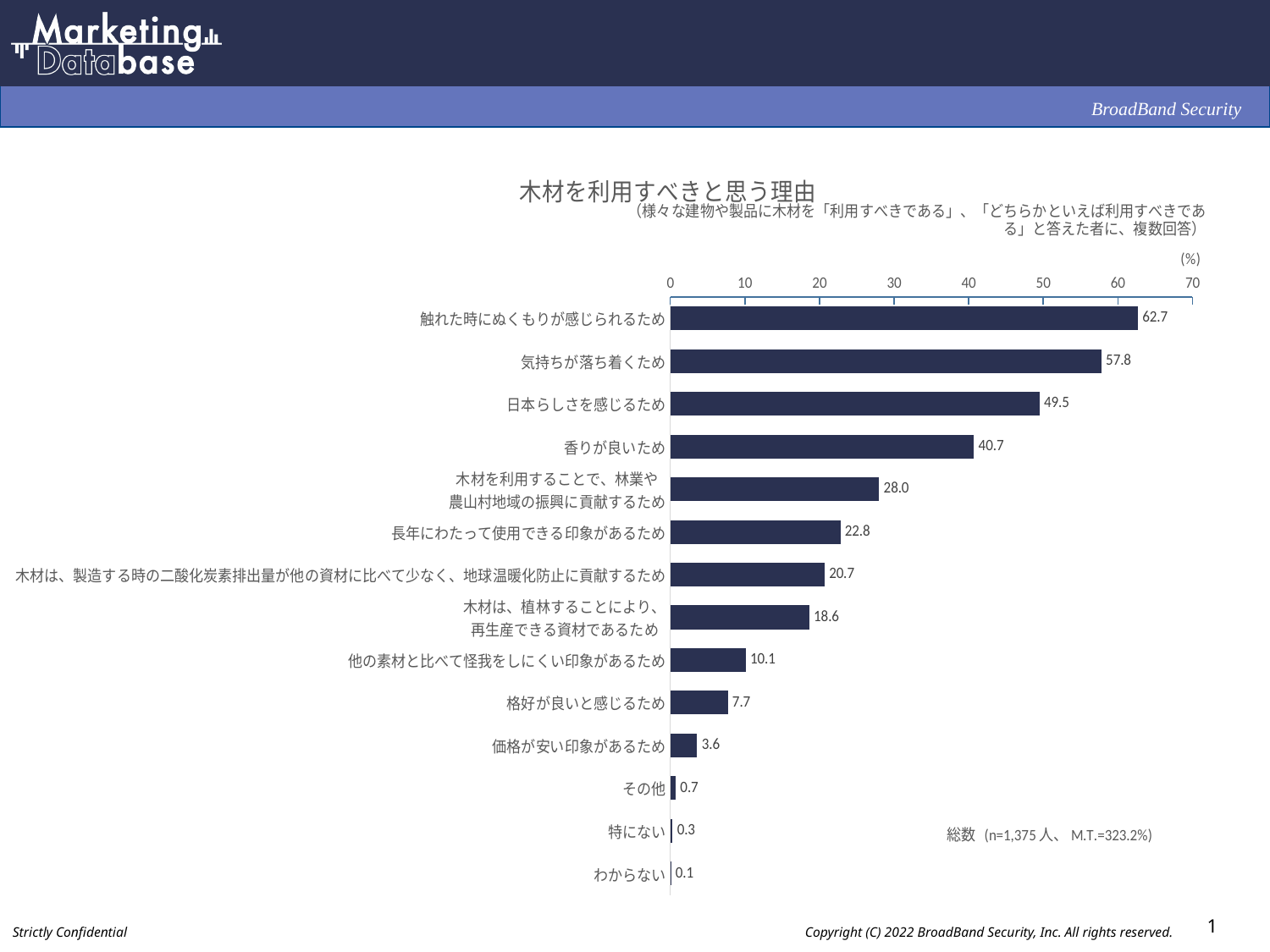
What is the sample size (n) shown on the chart? 1,375 What is the value for 香りが良いため? 40.7 Which category has the lowest value? わからない How many categories are shown in the chart? 14 What is the value for 触れた時にぬくもりが感じられるため? 62.7 What is the value for 価格が安い印象があるため? 3.6 Which category has the highest value? 触れた時にぬくもりが感じられるため What is the difference between the values for 気持ちが落ち着くため and 日本らしさを感じるため? 8.3 What kind of chart is shown on the slide? bar chart Which is larger, the value for 長年にわたって使用できる印象があるため or the value for 他の素材と比べて怪我をしにくい印象があるため? 長年にわたって使用できる印象があるため Is the value for 木材を利用することで、林業や農山村地域の振興に貢献するため greater or less than 30? less What is the title of the chart? 木材を利用すべきと思う理由